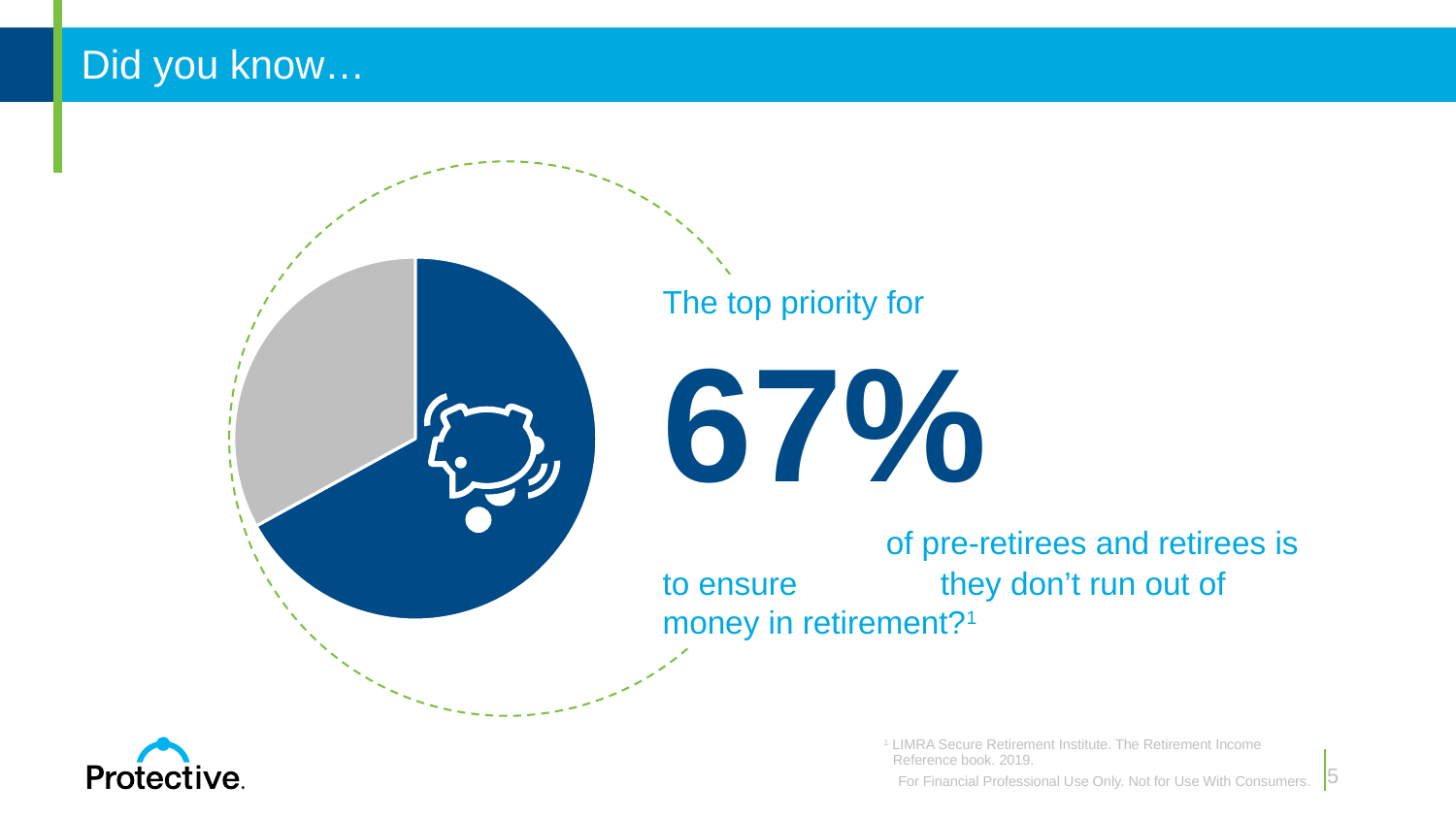
What icon is shown inside the dark blue slice of the pie chart? A piggy bank What percentage of pre-retirees and retirees say their top priority is to ensure they don't run out of money in retirement, according to the slide? 67% What kind of chart is shown on the slide? Pie chart What share of the pie does the gray slice represent? 33% Which slice of the pie chart is the smallest? The gray slice Is the share of the gray slice greater or less than 50%? less Which slice of the pie chart is larger, the dark blue one or the gray one? The dark blue one Is the share of the dark blue slice greater or less than 50%? greater What share of the pie does the dark blue slice represent? 67% What is the title of the slide containing the pie chart? Did you know… How many slices does the pie chart have? 2